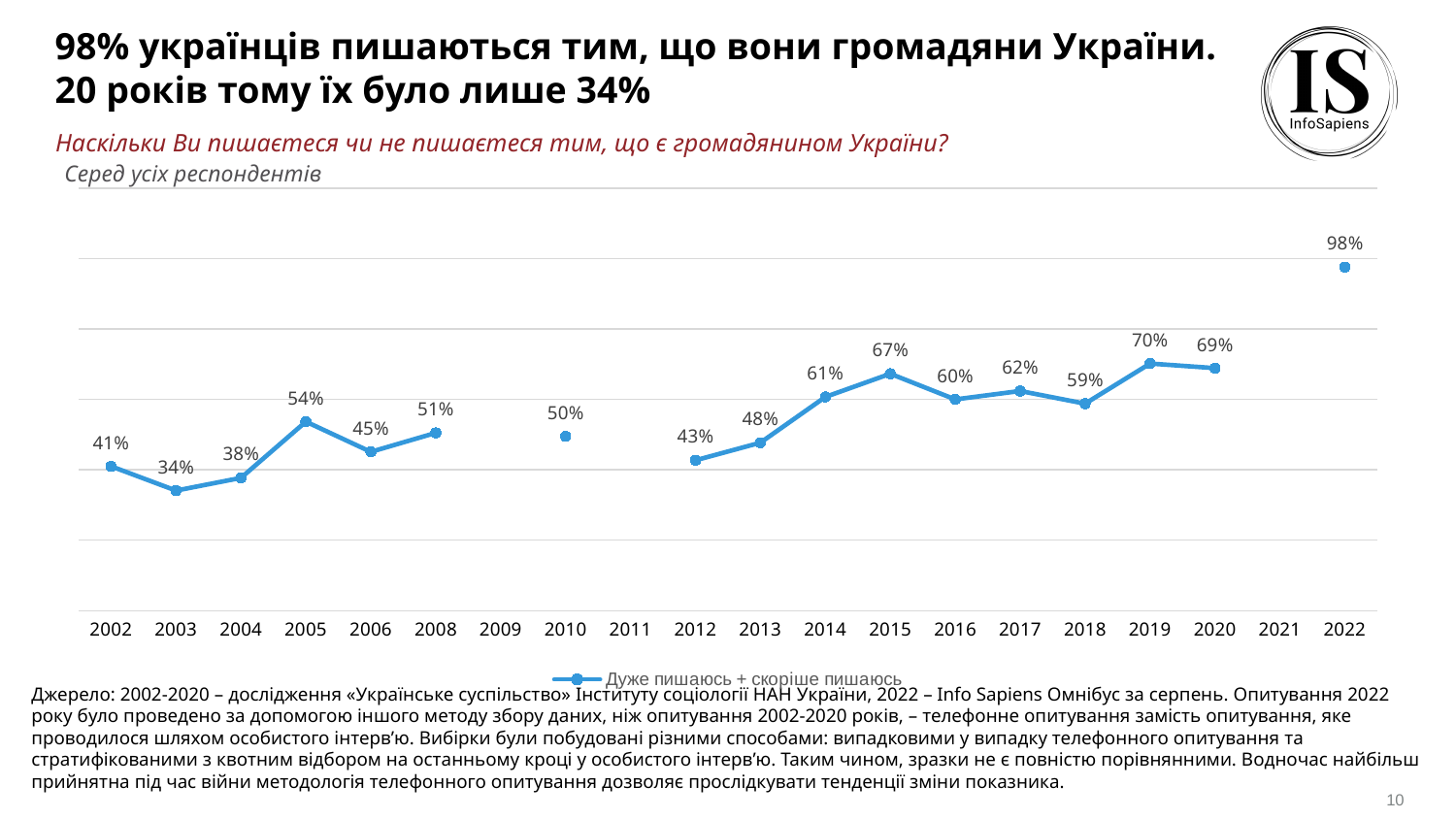
Which year has the lowest value? 2003 What is the difference between the values for 2022 and 2020? 29% What is the legend entry for the plotted series? Дуже пишаюсь + скоріше пишаюсь What is the value for 2003? 34% Which is larger, the value for 2019 or the value for 2018? 2019 What type of chart is shown on the slide? line chart What is the value for 2015? 67% What is the difference between the values for 2005 and 2004? 16% How many data points are plotted on the line? 17 What is the value for 2010? 50% How many series does the legend list? 1 Which year has the highest value? 2022